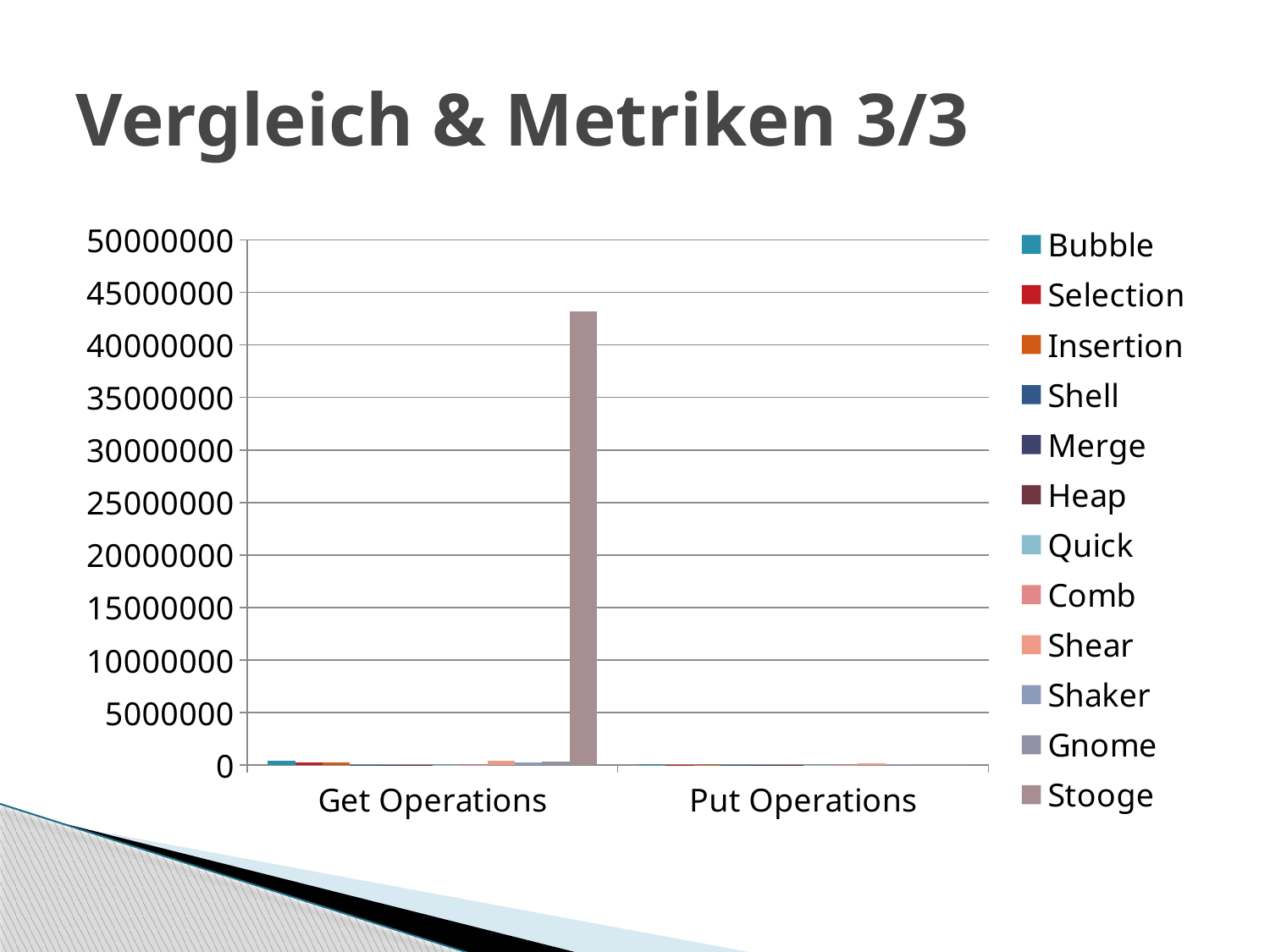
Which series has the highest value for Get Operations? Stooge Is the Stooge value for Get Operations greater or less than 40000000? greater Which category contains the tallest bar in the chart? Get Operations Is the Stooge value for Get Operations greater or less than 45000000? less How many categories are shown on the x axis? 2 How many series does the legend list? 12 Which is larger for the Stooge series: Get Operations or Put Operations? Get Operations Is the Bubble value for Get Operations greater or less than 5000000? less What is the highest value shown on the y axis? 50000000 What kind of chart is shown on the slide? bar chart Which series is listed first in the legend? Bubble